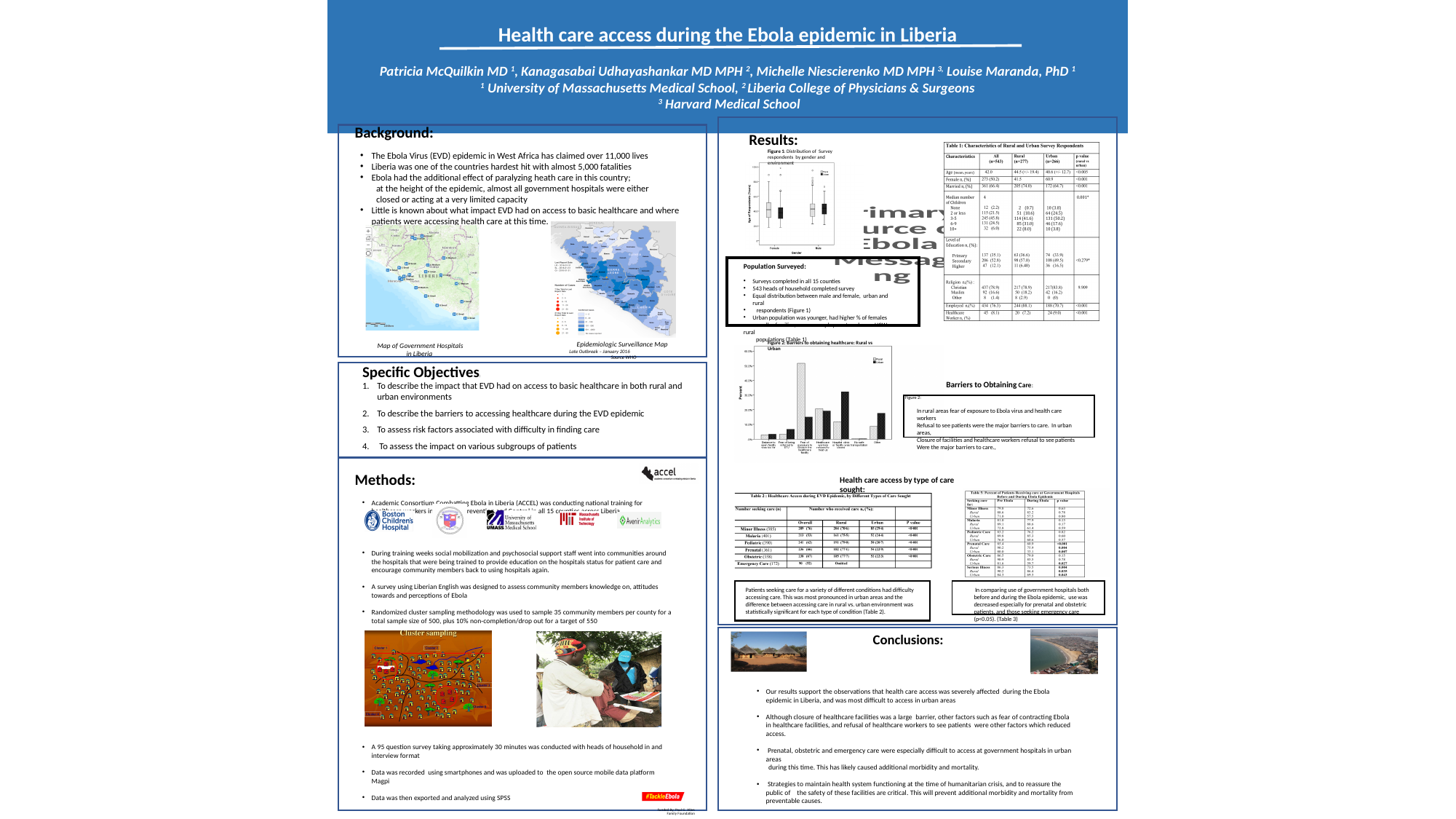
What is the label of the y axis in Figure 2 (Barriers to obtaining healthcare)? Percent In Figure 2 (Barriers to obtaining healthcare), which is larger for 'Fear of exposure to Ebola in the healthcare facility': the Rural value or the Urban value? Rural In Figure 2 (Barriers to obtaining healthcare), which barrier has the highest Rural value? Fear of exposure to Ebola in the healthcare facility In Figure 2 (Barriers to obtaining healthcare), is the Urban value for 'Hospital, clinic or facility was closed' greater or less than 20%? greater In Figure 2 (Barriers to obtaining healthcare), is the Rural value for 'Fear of exposure to Ebola in the healthcare facility' greater or less than 40%? greater What kind of chart is Figure 2, 'Barriers to obtaining healthcare: Rural vs Urban'? Bar chart How many gender categories are shown on the x axis of Figure 1 (Distribution of Survey respondents by gender and environment)? 2 How many series does the legend of Figure 2 (Barriers to obtaining healthcare) list? 2 In Figure 2 (Barriers to obtaining healthcare), which is larger for 'Hospital, clinic or facility was closed': the Rural value or the Urban value? Urban What kind of chart is Figure 1, 'Distribution of Survey respondents by gender and environment'? Box plot What are the two series named in the legend of Figure 2 (Barriers to obtaining healthcare)? Rural and Urban